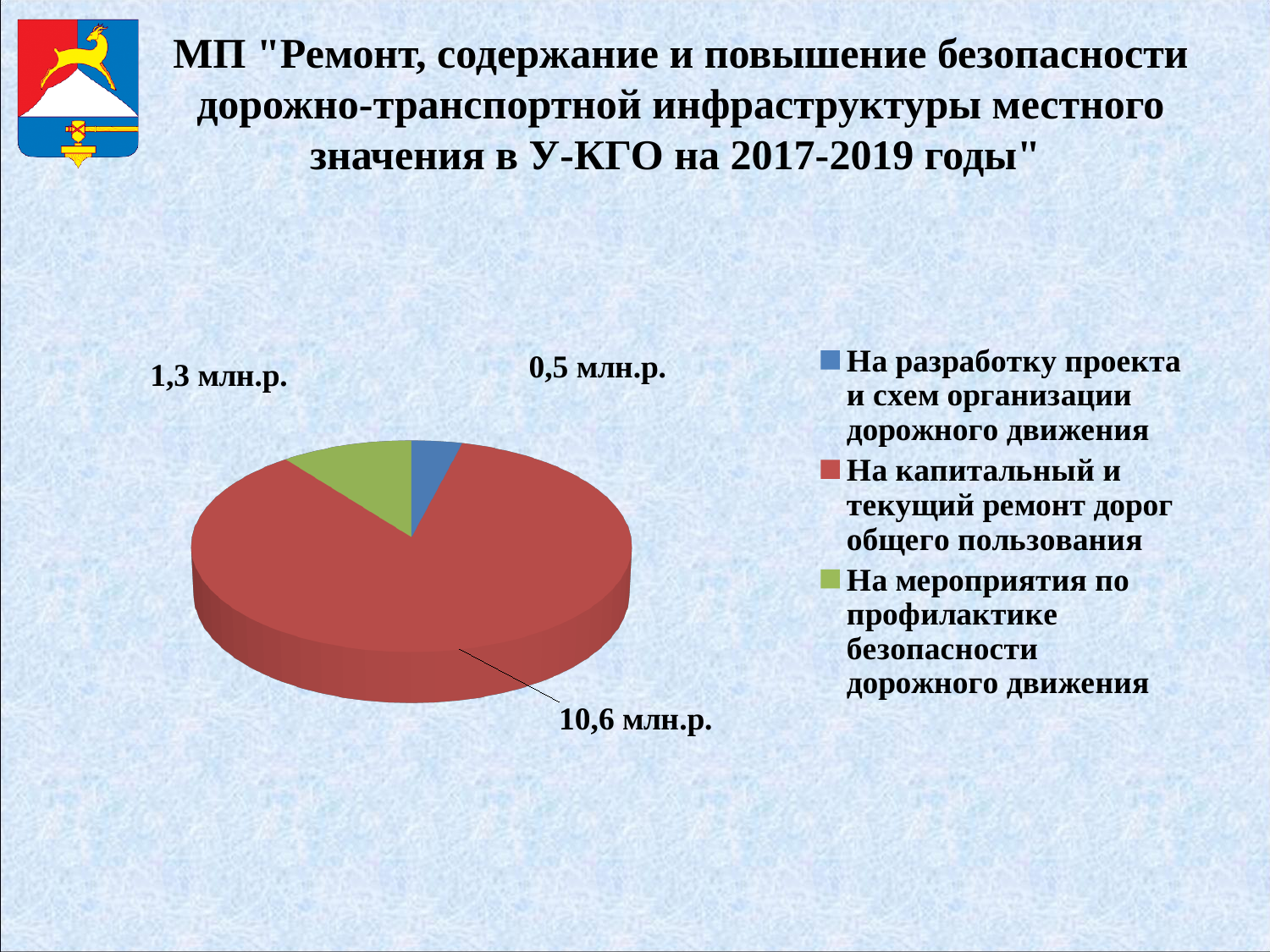
How many entries does the legend list? 3 What is the value for "На капитальный и текущий ремонт дорог общего пользования"? 10,6 млн.р. What is the difference between the value for "На капитальный и текущий ремонт дорог общего пользования" and the value for "На мероприятия по профилактике безопасности дорожного движения"? 9,3 млн.р. What is the value for "На разработку проекта и схем организации дорожного движения"? 0,5 млн.р. What is the total of all three slices of the pie? 12,4 млн.р. Which category has the smallest slice of the pie? На разработку проекта и схем организации дорожного движения Which colour represents "На капитальный и текущий ремонт дорог общего пользования" in the pie chart? Red What kind of chart is shown on the slide? Pie chart Which is larger: the value for "На мероприятия по профилактике безопасности дорожного движения" or the value for "На разработку проекта и схем организации дорожного движения"? На мероприятия по профилактике безопасности дорожного движения How many slices does the pie chart have? 3 What is the value for "На мероприятия по профилактике безопасности дорожного движения"? 1,3 млн.р. Which category has the largest slice of the pie? На капитальный и текущий ремонт дорог общего пользования